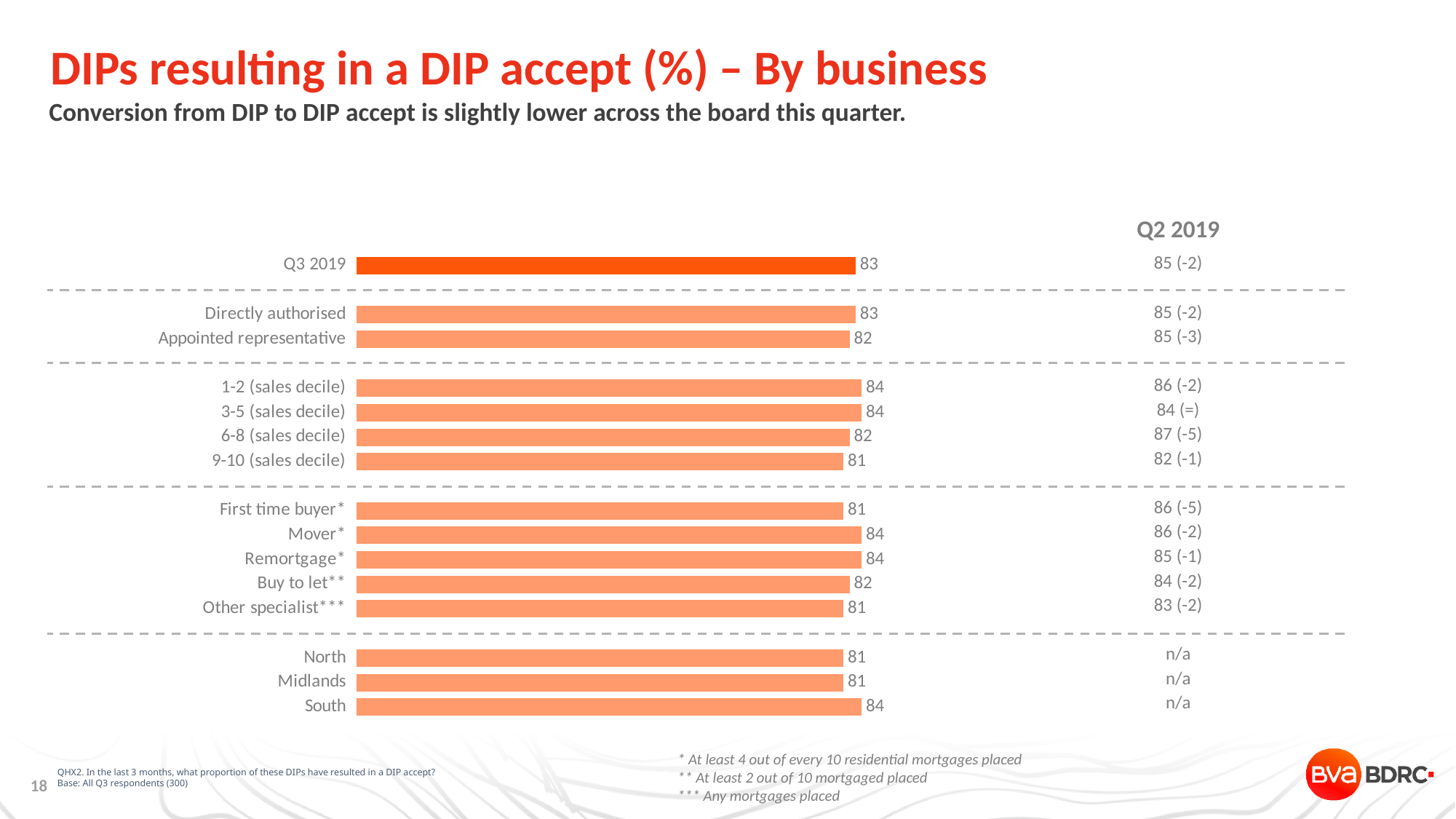
How many bars are plotted in the chart? 15 What is the value for Directly authorised? 83 Among the regions North, Midlands and South, which has the highest value? South What is the value for Buy to let? 82 What is the difference between the values for 1-2 (sales decile) and 9-10 (sales decile)? 3 What is the value for the Q3 2019 bar at the top of the chart? 83 What is the difference between the values for South and North? 3 What kind of chart is shown on the slide? Bar chart What is the value for 9-10 (sales decile)? 81 Among the sales decile categories, which has the lowest value? 9-10 (sales decile) Which has the larger value, Directly authorised or Appointed representative? Directly authorised What is the title of the slide? DIPs resulting in a DIP accept (%) – By business